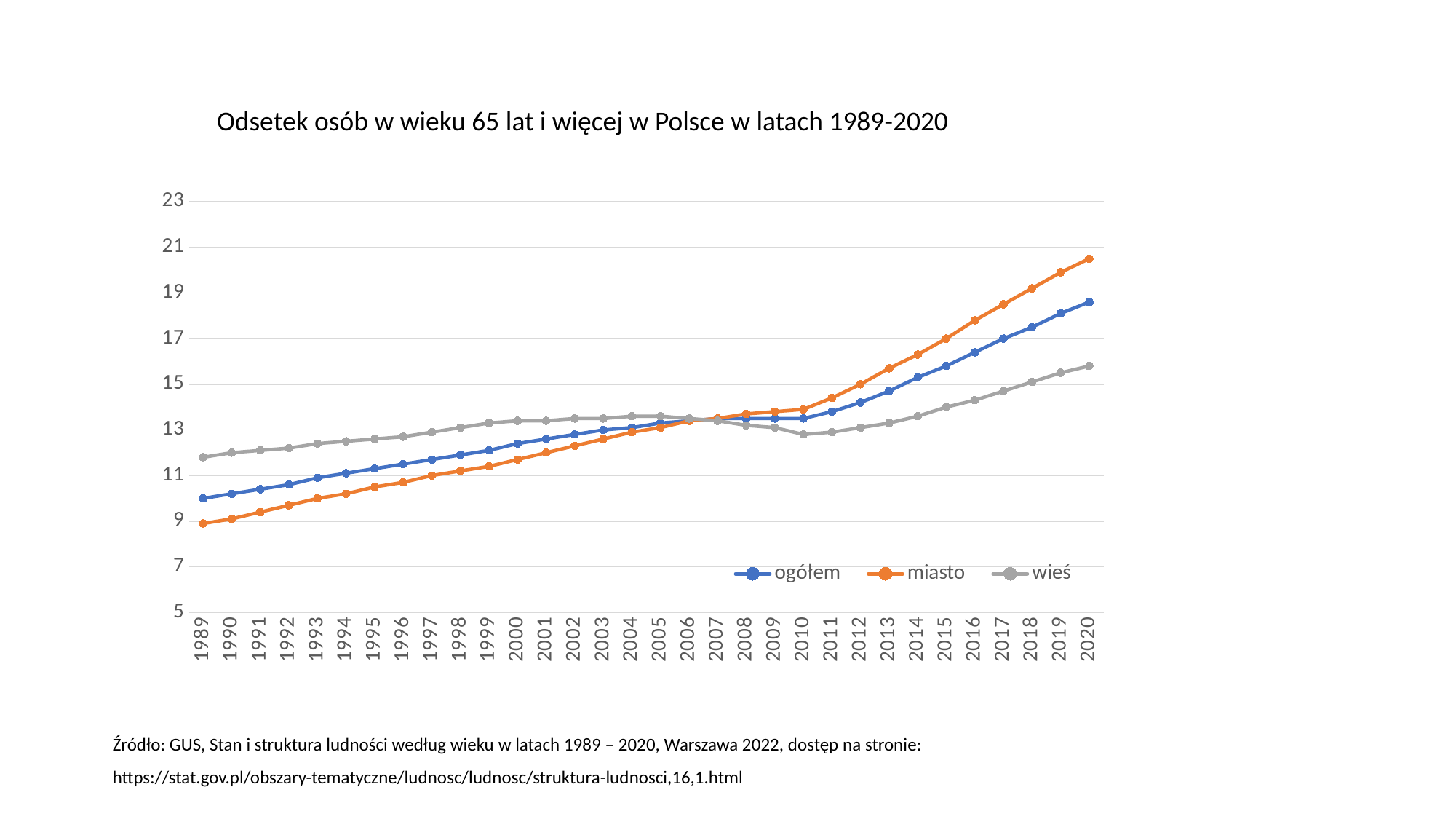
Which is larger in 1989, the value for wieś or the value for miasto? wieś What is the title of the chart? Odsetek osób w wieku 65 lat i więcej w Polsce w latach 1989-2020 Which series is drawn in orange? miasto Which series has the highest value in 2020? miasto In which year does the miasto series reach its highest value? 2020 How many years are plotted along the x axis? 32 How many series does the legend list? 3 Is the value for miasto in 2020 greater or less than 19? greater Is the value for ogółem in 1989 greater or less than 11? less Which series has the lowest value in 1989? miasto Is the value for wieś in 2020 greater or less than 17? less What kind of chart is shown on the slide? line chart